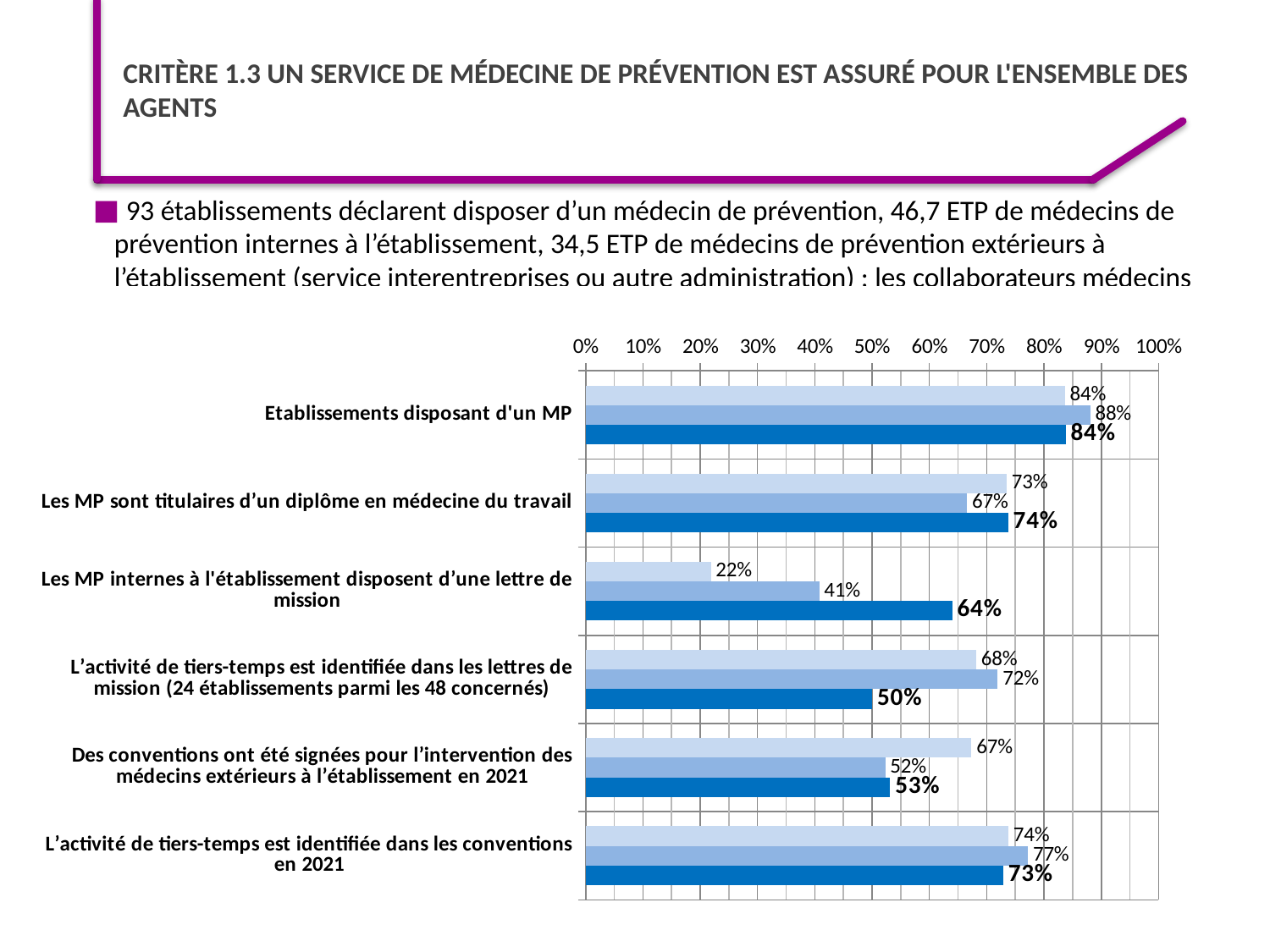
What is the difference between the dark blue (bottom) bar and the light blue (top) bar for "Les MP internes à l'établissement disposent d'une lettre de mission"? 42 percentage points What is the value of the light blue (top) bar for "Les MP internes à l'établissement disposent d'une lettre de mission"? 22% For "Des conventions ont été signées pour l'intervention des médecins extérieurs à l'établissement en 2021", which is larger: the light blue (top) bar or the dark blue (bottom) bar? the light blue (top) bar What is the value of the dark blue (bottom) bar for "Les MP internes à l'établissement disposent d'une lettre de mission"? 64% Is the value of the middle bar for "Les MP internes à l'établissement disposent d'une lettre de mission" greater or less than 50%? less What kind of chart is shown on the slide? bar chart What is the value of the middle bar for "Etablissements disposant d'un MP"? 88% Which category has the lowest value among the dark blue (bottom) bars? L'activité de tiers-temps est identifiée dans les lettres de mission (24 établissements parmi les 48 concernés) Which category has the highest value among the dark blue (bottom) bars? Etablissements disposant d'un MP How many categories are shown on the chart? 6 How many bars are shown for each category on the chart? 3 What is the value of the dark blue (bottom) bar for "L'activité de tiers-temps est identifiée dans les lettres de mission (24 établissements parmi les 48 concernés)"? 50%